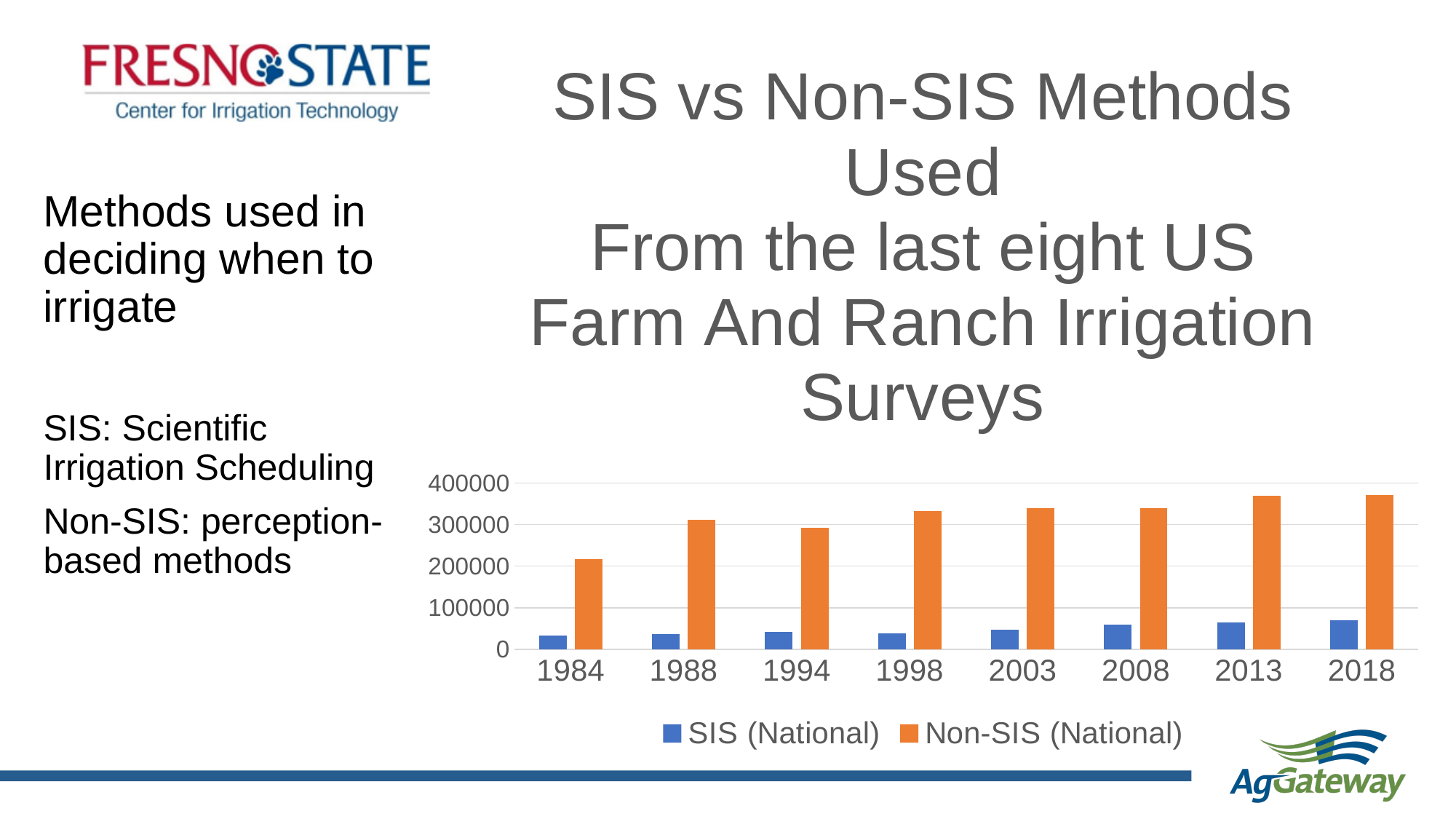
Is the Non-SIS (National) value for 2013 greater or less than 300000? greater In which year is the Non-SIS (National) value lowest? 1984 What kind of chart is shown on the slide? Bar chart Is the Non-SIS (National) value for 1984 greater or less than 300000? less How many series does the chart legend list? 2 Which is larger: the Non-SIS (National) value for 1984 or for 2008? 2008 What are the two legend entries of the chart? SIS (National) and Non-SIS (National) How many survey years are shown on the x axis of the chart? 8 Does the Non-SIS (National) series generally rise or fall from 1984 to 2018? rise Is the SIS (National) value for 2018 greater or less than 100000? less Which is larger in 2008: SIS (National) or Non-SIS (National)? Non-SIS (National) Which series is shown in orange in the chart? Non-SIS (National)